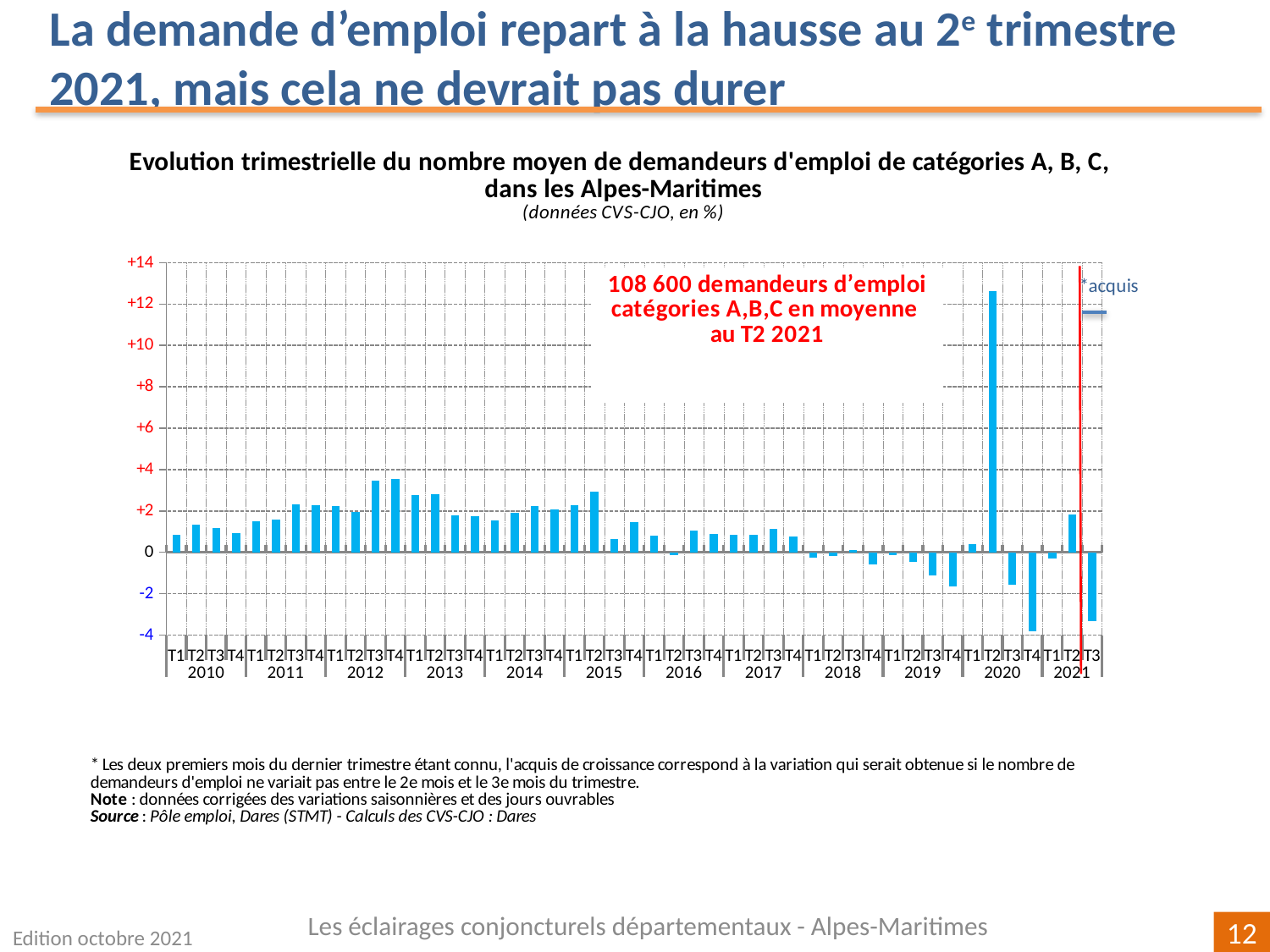
How many years are labelled on the x axis of the chart? 12 What kind of chart is shown on the slide? bar chart According to the annotation on the chart, how many demandeurs d'emploi of categories A, B, C were there on average in T2 2021? 108 600 Is the value for T3 2019 greater or less than 0? less Do the values generally rise or fall from 2015 to 2019? fall Is the value for T4 2020 greater or less than -2? less How many quarters of 2021 are shown in the chart? 3 Is the value for T2 2020 greater or less than +10? greater Which is larger, the value for T2 2021 or the value for T3 2021? T2 2021 Which quarter has the highest value in the chart? T2 2020